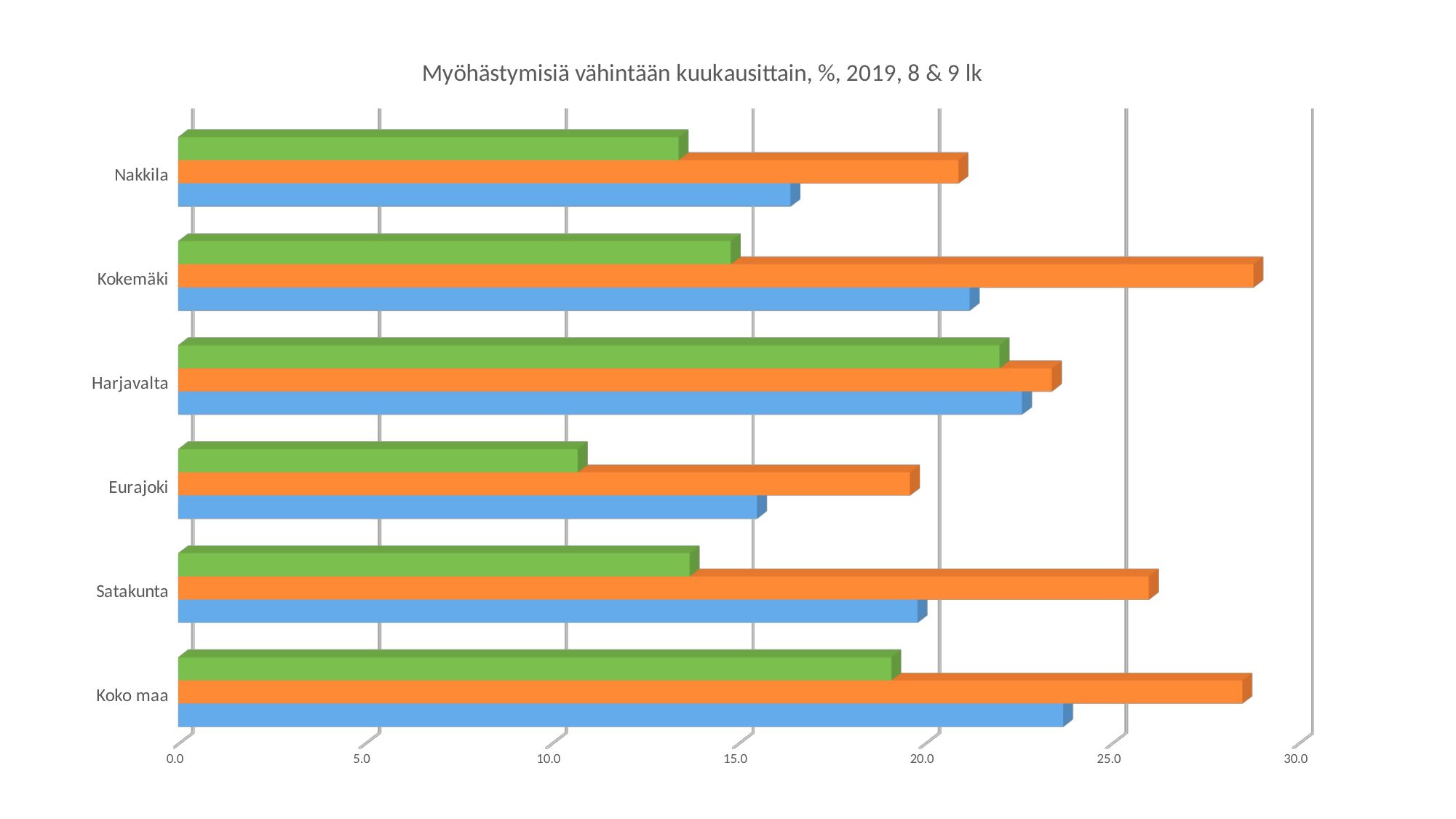
For Eurajoki, which is larger: the orange bar or the blue bar? the orange bar What is the title of the chart? Myöhästymisiä vähintään kuukausittain, %, 2019, 8 & 9 lk How many categories are shown on the vertical axis of the chart? 6 For Kokemäki, which is larger: the orange bar or the green bar? the orange bar Is the value of the green bar for Nakkila greater or less than 15.0? less How many bars are plotted for each category in the chart? 3 Which category has the shortest green bar? Eurajoki What kind of chart is shown on the slide? bar chart Is the value of the green bar for Harjavalta greater or less than 20.0? greater Is the value of the orange bar for Kokemäki greater or less than 25.0? greater Which category has the shortest orange bar? Eurajoki Which category has the longest green bar? Harjavalta